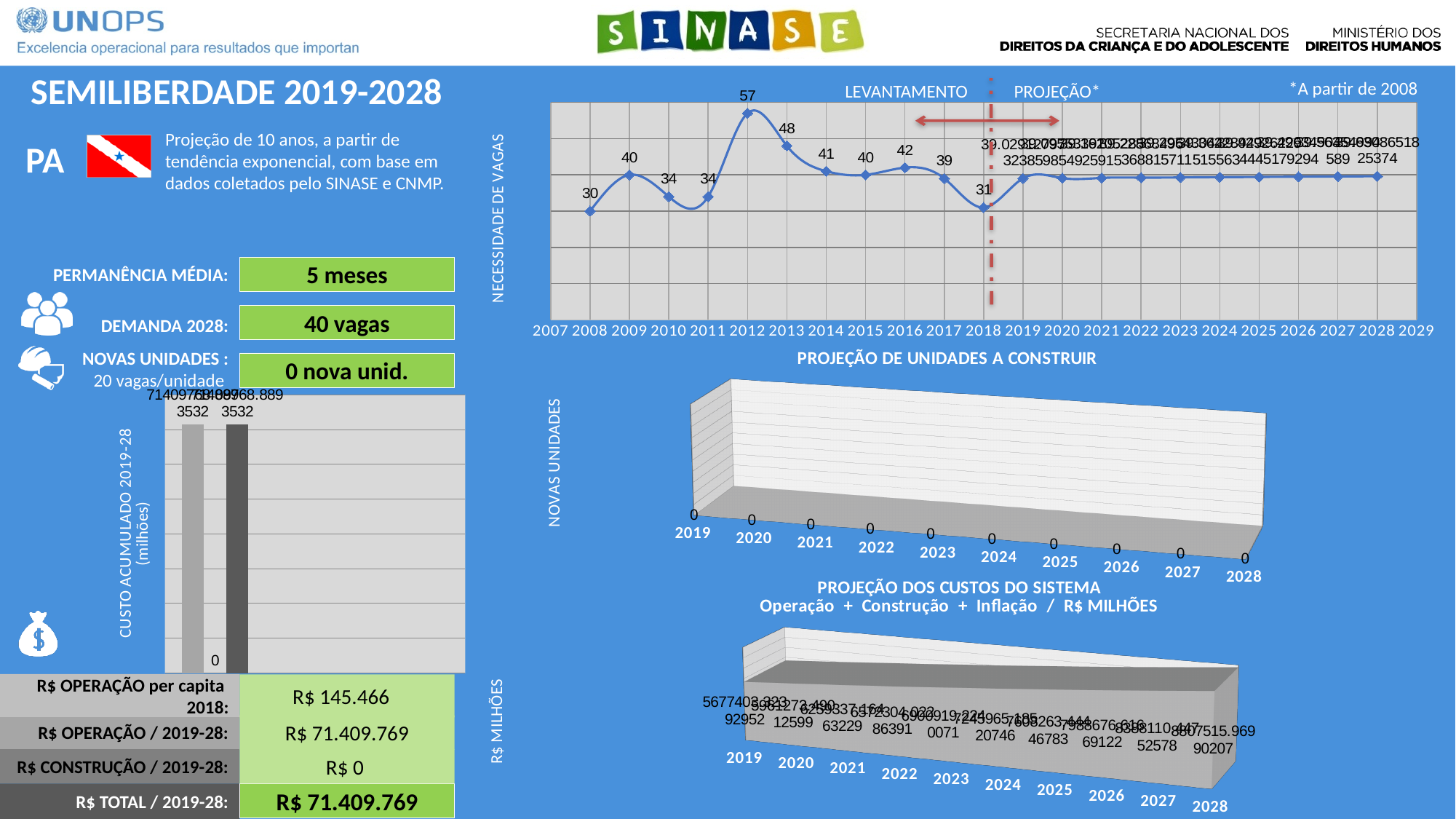
In the NECESSIDADE DE VAGAS line chart, what is the difference between the values for 2012 and 2013? 9 In the NECESSIDADE DE VAGAS line chart, do the values rise or fall from 2012 to 2018? fall In the NECESSIDADE DE VAGAS line chart, which year in the LEVANTAMENTO period (2008-2018) has the lowest value? 2008 In the NECESSIDADE DE VAGAS line chart, which year in the LEVANTAMENTO period (2008-2018) has the highest value? 2012 What kind of chart is the NECESSIDADE DE VAGAS chart? line chart In the NECESSIDADE DE VAGAS line chart, which year has the larger value, 2009 or 2010? 2009 In the NECESSIDADE DE VAGAS line chart, what is the value for 2012? 57 In the PROJEÇÃO DE UNIDADES A CONSTRUIR chart, what is the value for 2025? 0 In the NECESSIDADE DE VAGAS line chart, what is the value for 2018? 31 How many years are shown on the x axis of the PROJEÇÃO DE UNIDADES A CONSTRUIR chart? 10 In the NECESSIDADE DE VAGAS line chart, what is the value for 2008? 30 What kind of chart is the PROJEÇÃO DE UNIDADES A CONSTRUIR chart? 3D area chart